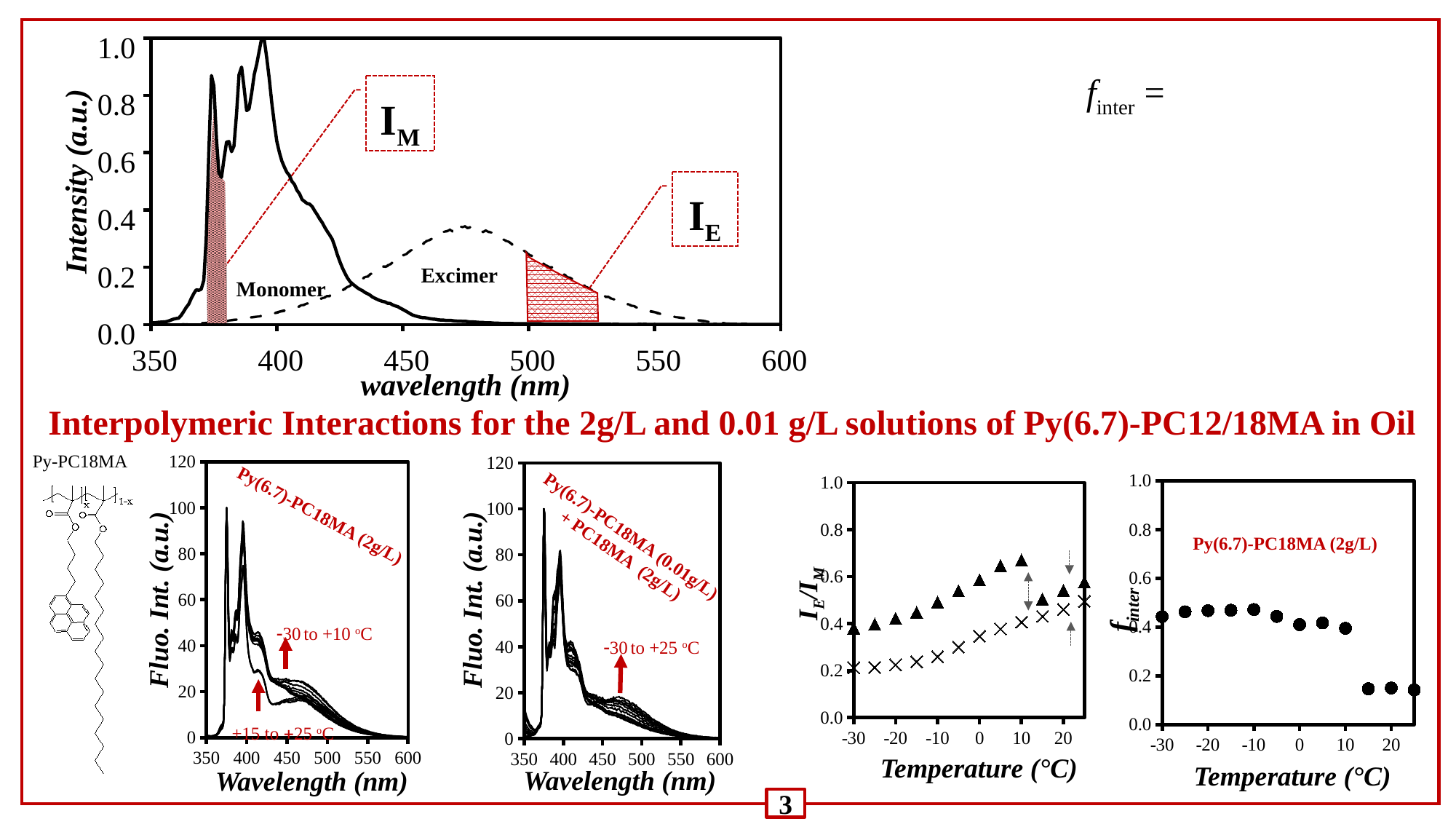
In the IE/IM vs Temperature chart, at -30 °C, which series has the larger value, the triangles or the crosses? triangles In the bottom-left fluorescence spectrum labelled Py(6.7)-PC18MA (2g/L), what is the highest value shown on the y axis? 120 In the top-left intensity vs wavelength chart, which of the two labelled bands, Monomer or Excimer, reaches the higher peak intensity? Monomer In the f_inter vs Temperature chart, is the value at 20 °C greater or less than 0.2? less In the second fluorescence spectrum (Py(6.7)-PC18MA + PC18MA (0.01g/L)), what temperature range is written next to the red arrow? -30 to +25 °C In the IE/IM vs Temperature chart, how many data series are plotted? 2 In the top-left intensity vs wavelength chart, what is the label of the x axis? wavelength (nm) In the bottom-left fluorescence spectrum labelled Py(6.7)-PC18MA (2g/L), what temperature range is written next to the upward arrow near 450 nm? -30 to +10 °C In the IE/IM vs Temperature chart, do the values generally rise or fall as temperature increases from -30 to 10 °C? rise What kind of chart is the top-left intensity vs wavelength plot? line chart In the IE/IM vs Temperature chart, is the cross-marker value at -30 °C greater or less than 0.4? less In the top-left intensity vs wavelength chart, is the peak of the Excimer (dashed) curve greater or less than 0.2? greater